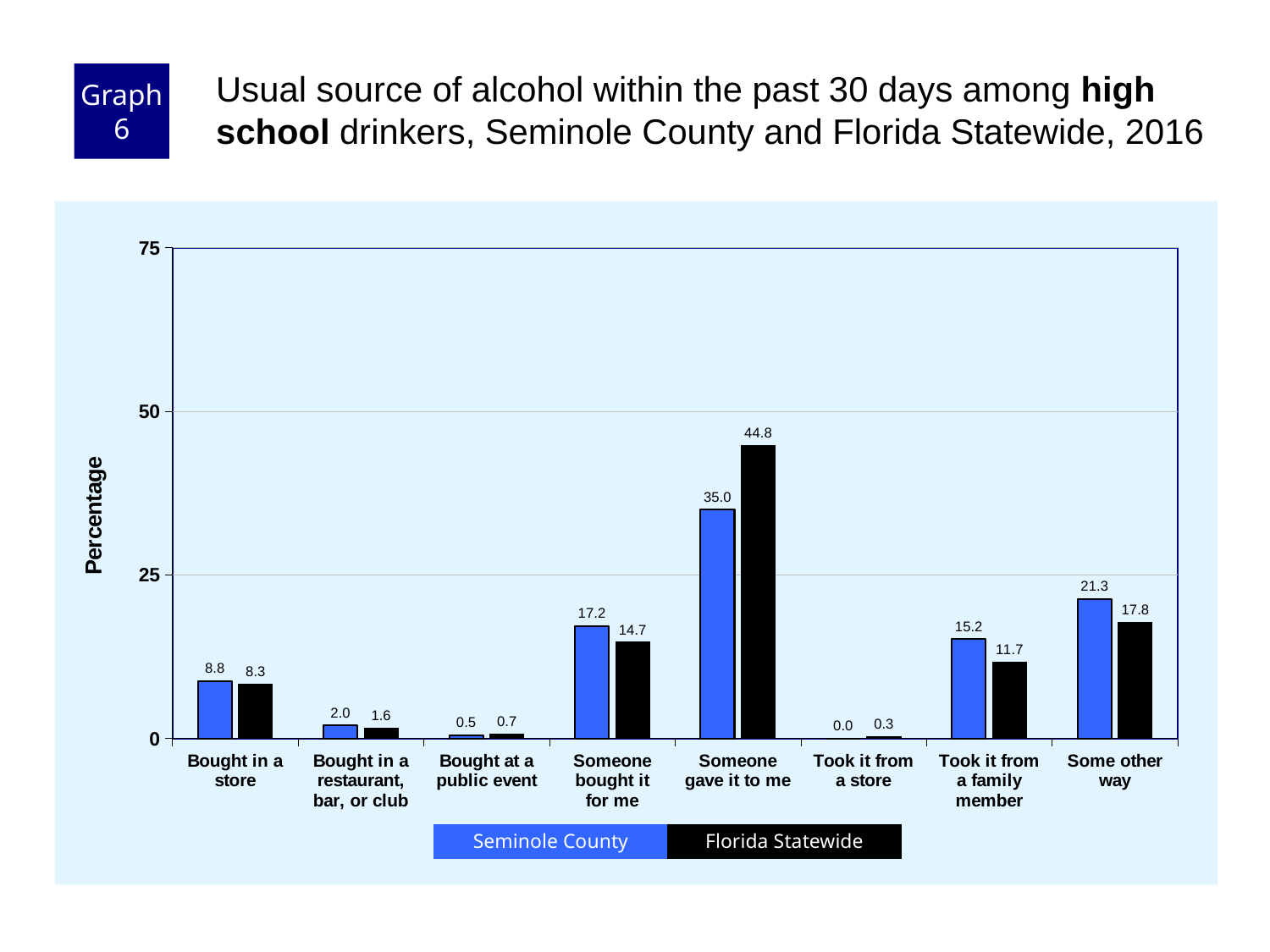
What is the difference between the Seminole County and Florida Statewide values for "Some other way"? 3.5 Is the Florida Statewide value for "Someone gave it to me" greater or less than 50? less What is the Seminole County value for "Someone gave it to me"? 35.0 Which category has the lowest Seminole County value? Took it from a store How many categories are shown on the x axis? 8 What is the Seminole County value for "Bought at a public event"? 0.5 What is the difference between the Florida Statewide and Seminole County values for "Someone gave it to me"? 9.8 Which is larger for "Someone bought it for me": Seminole County or Florida Statewide? Seminole County What is the Florida Statewide value for "Took it from a family member"? 11.7 Which category has the highest Florida Statewide value? Someone gave it to me What kind of chart is shown on the slide? bar chart How many series does the legend list? 2